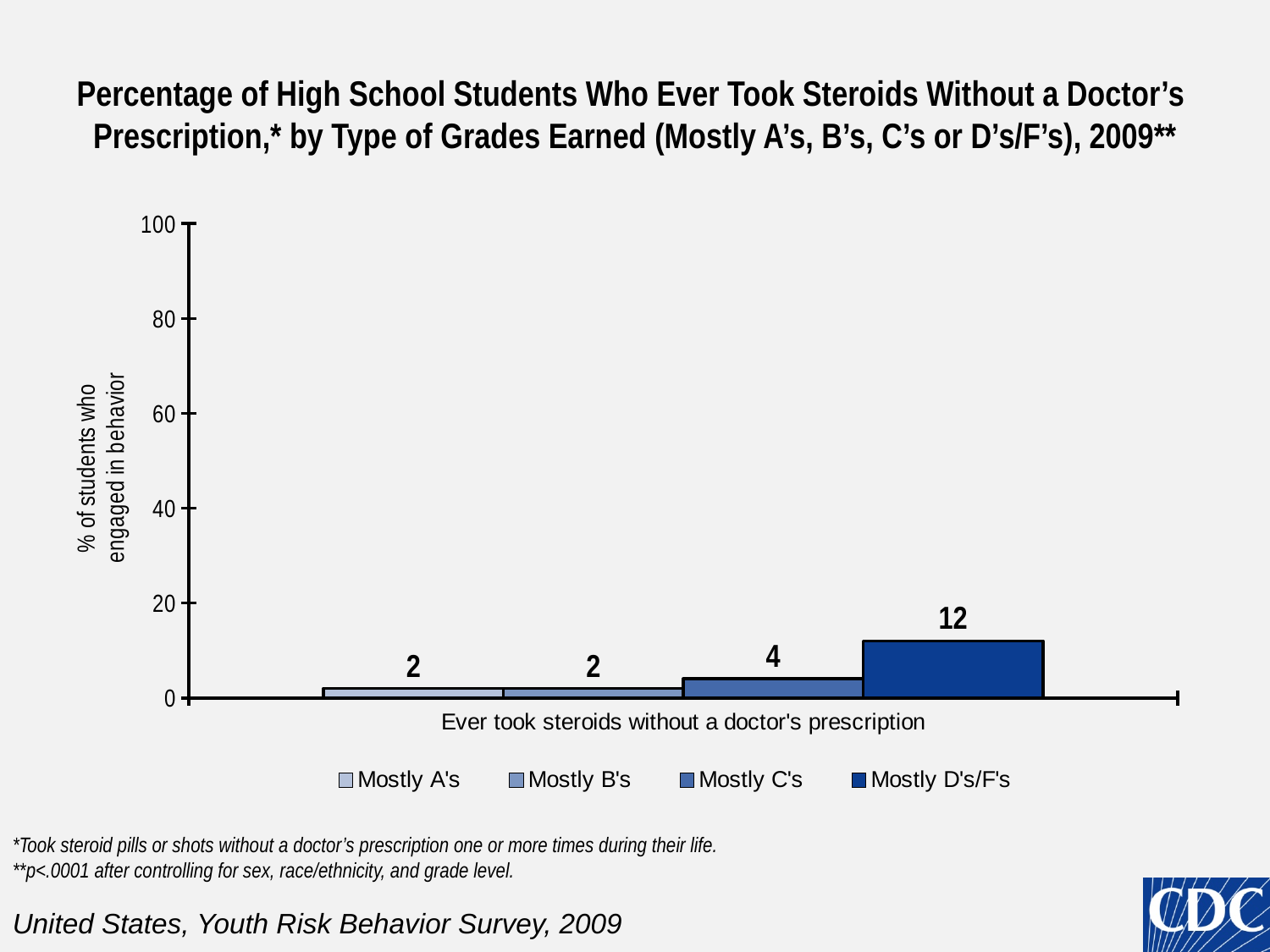
Which is larger, the value for Mostly C's or the value for Mostly B's? Mostly C's What is the difference between the values for Mostly C's and Mostly B's? 2 What is the value for Mostly A's? 2 What is the label on the y axis? % of students who engaged in behavior What kind of chart is shown on the slide? Bar chart Is the value for Mostly D's/F's greater or less than 20? less Which grade group has the highest percentage of students who ever took steroids without a doctor's prescription? Mostly D's/F's What percentage of students with Mostly D's/F's ever took steroids without a doctor's prescription? 12 What is the difference between the values for Mostly D's/F's and Mostly C's? 8 What is the value for Mostly C's? 4 How many series does the legend list? 4 Do the values rise or fall moving from Mostly A's to Mostly D's/F's? Rise